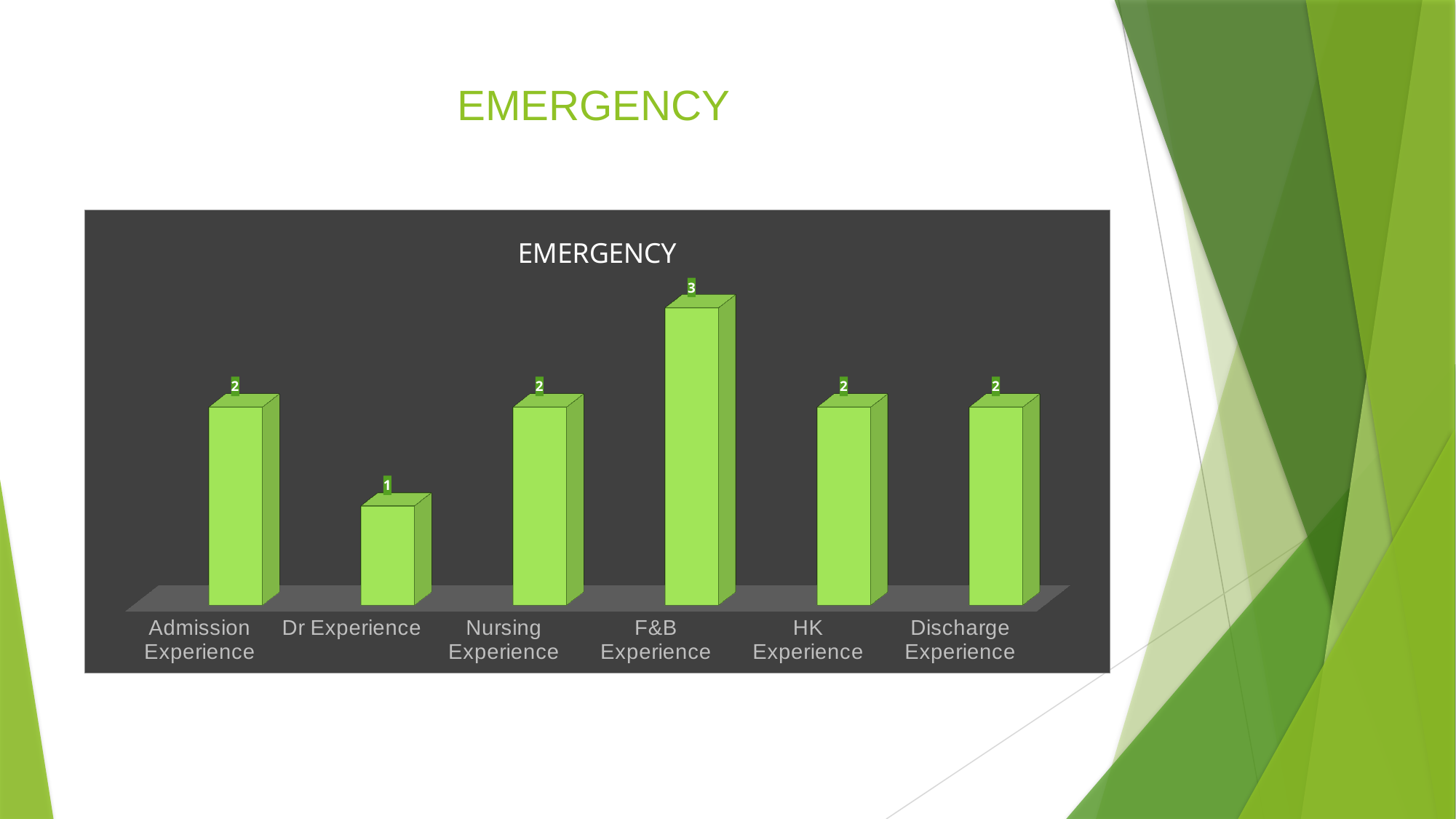
What is the title of the chart? EMERGENCY Which is larger, the value for Nursing Experience or the value for Dr Experience? Nursing Experience What is the difference between the values for F&B Experience and Dr Experience? 2 How many categories are shown on the x axis? 6 Which category has the highest value? F&B Experience What is the value for F&B Experience? 3 What is the value for HK Experience? 2 What is the value for Dr Experience? 1 What kind of chart is shown? Bar chart What is the value for Admission Experience? 2 Which category has the lowest value? Dr Experience What colour are the bars in the chart? Green